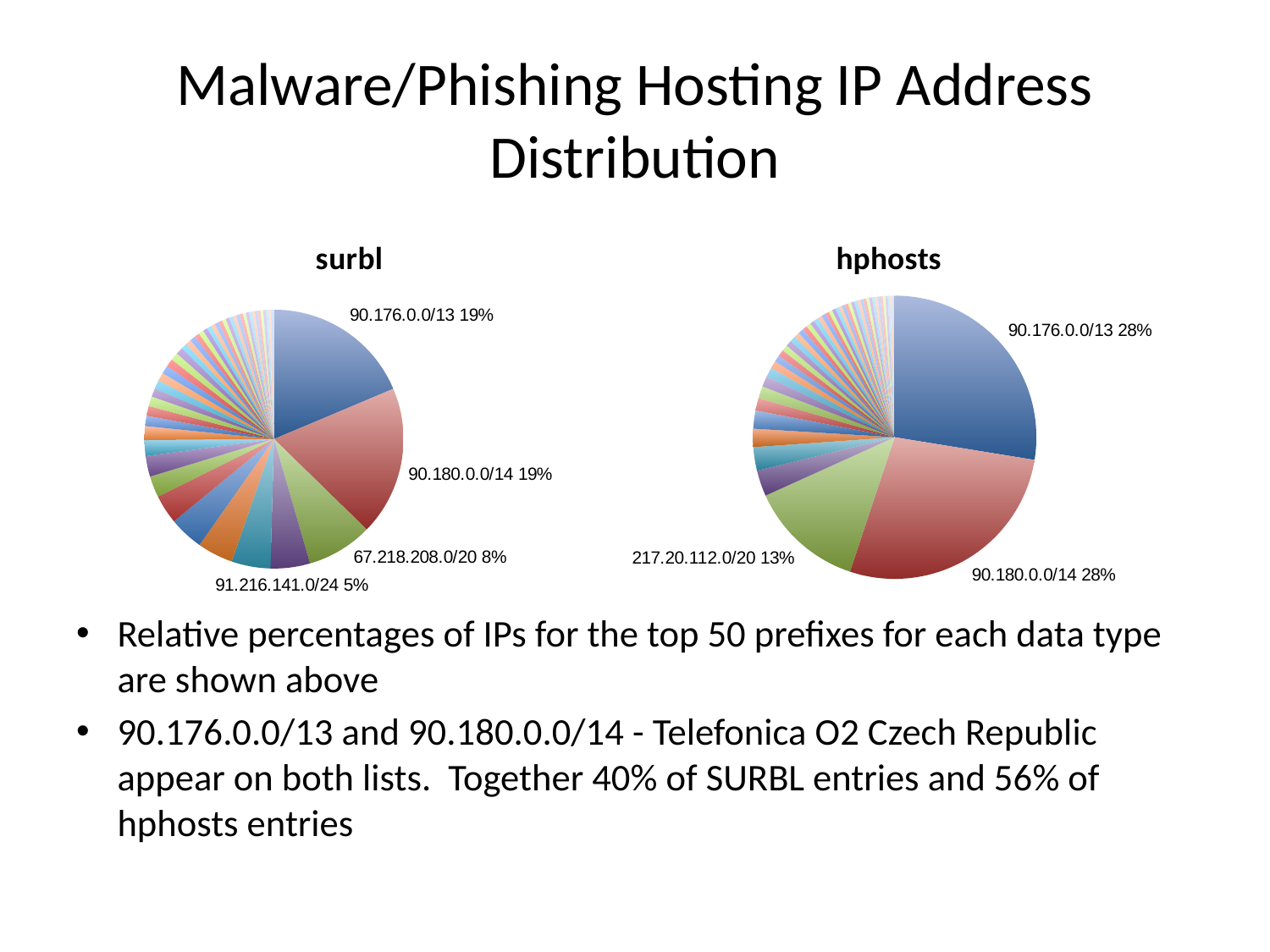
In the surbl chart, what share is labelled for 67.218.208.0/20? 8% In the hphosts chart, what share is labelled for 217.20.112.0/20? 13% What is the title of the pie chart on the right? hphosts What kind of chart is the surbl chart? pie chart In the surbl chart, which slice is larger: 67.218.208.0/20 or 91.216.141.0/24? 67.218.208.0/20 In the hphosts chart, what is the difference in percentage points between the 90.176.0.0/13 slice and the 217.20.112.0/20 slice? 15 percentage points In the hphosts chart, what share is labelled for 90.180.0.0/14? 28% Is the labelled share for 90.176.0.0/13 larger in the surbl chart or the hphosts chart? hphosts How many pie charts are shown on the slide? 2 In the surbl chart, what share is labelled for 90.176.0.0/13? 19% In the surbl chart, what share is labelled for 91.216.141.0/24? 5% In the surbl chart, what is the difference in percentage points between the 67.218.208.0/20 slice and the 91.216.141.0/24 slice? 3 percentage points